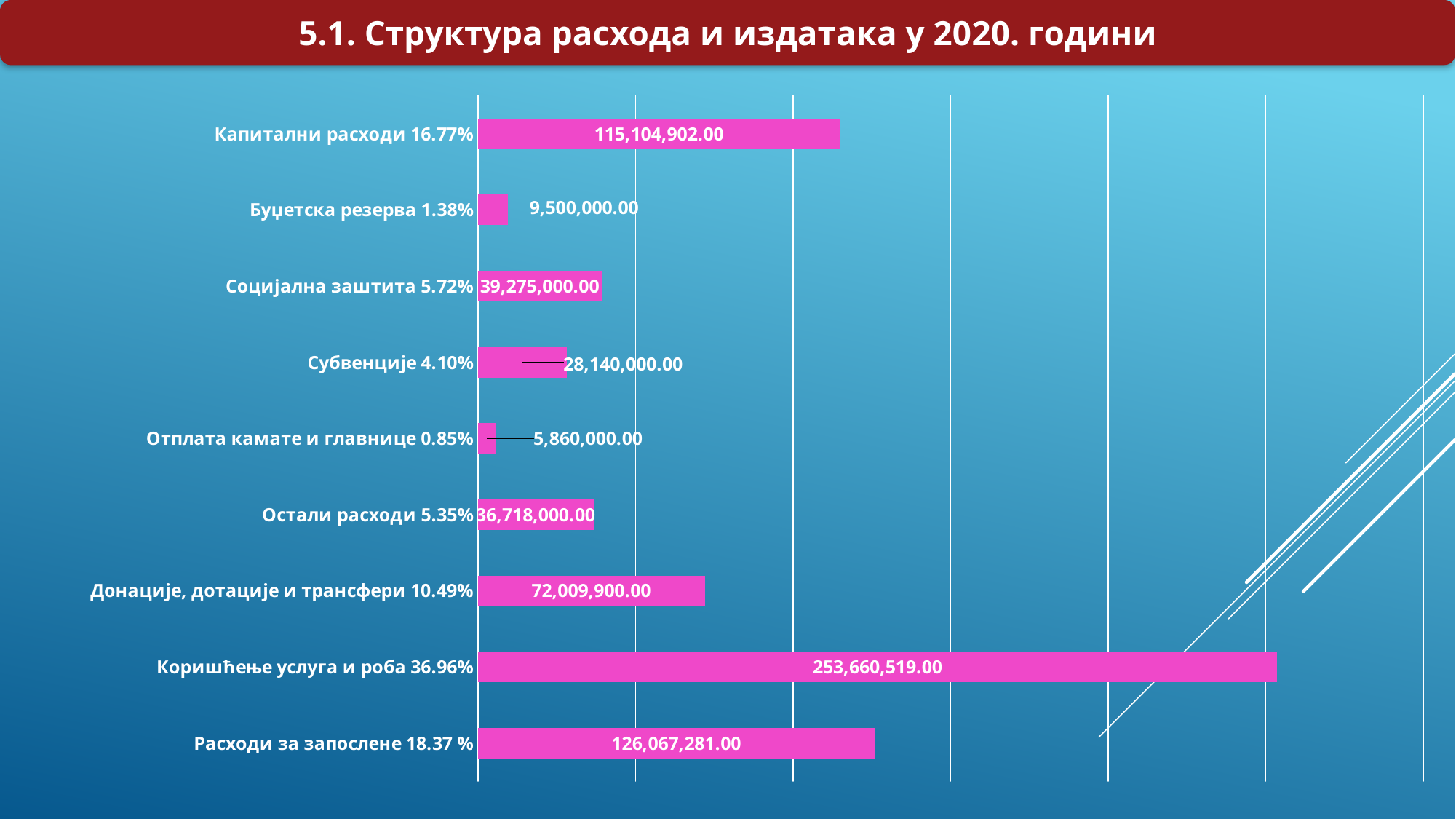
How many categories are shown in the chart? 9 What is the value for Отплата камате и главнице? 5,860,000.00 What kind of chart is shown on the slide? Bar chart What is the value for Буџетска резерва? 9,500,000.00 What is the value for Донације, дотације и трансфери? 72,009,900.00 What is the difference between the values for Расходи за запослене and Капитални расходи? 10,962,379.00 Which category has the lowest value? Отплата камате и главнице What is the difference between the values for Коришћење услуга и роба and Расходи за запослене? 127,593,238.00 Which category has the highest value? Коришћење услуга и роба What percentage share is shown in the label for Коришћење услуга и роба? 36.96% Which is larger, the value for Социјална заштита or the value for Остали расходи? Социјална заштита What is the value for Капитални расходи? 115,104,902.00